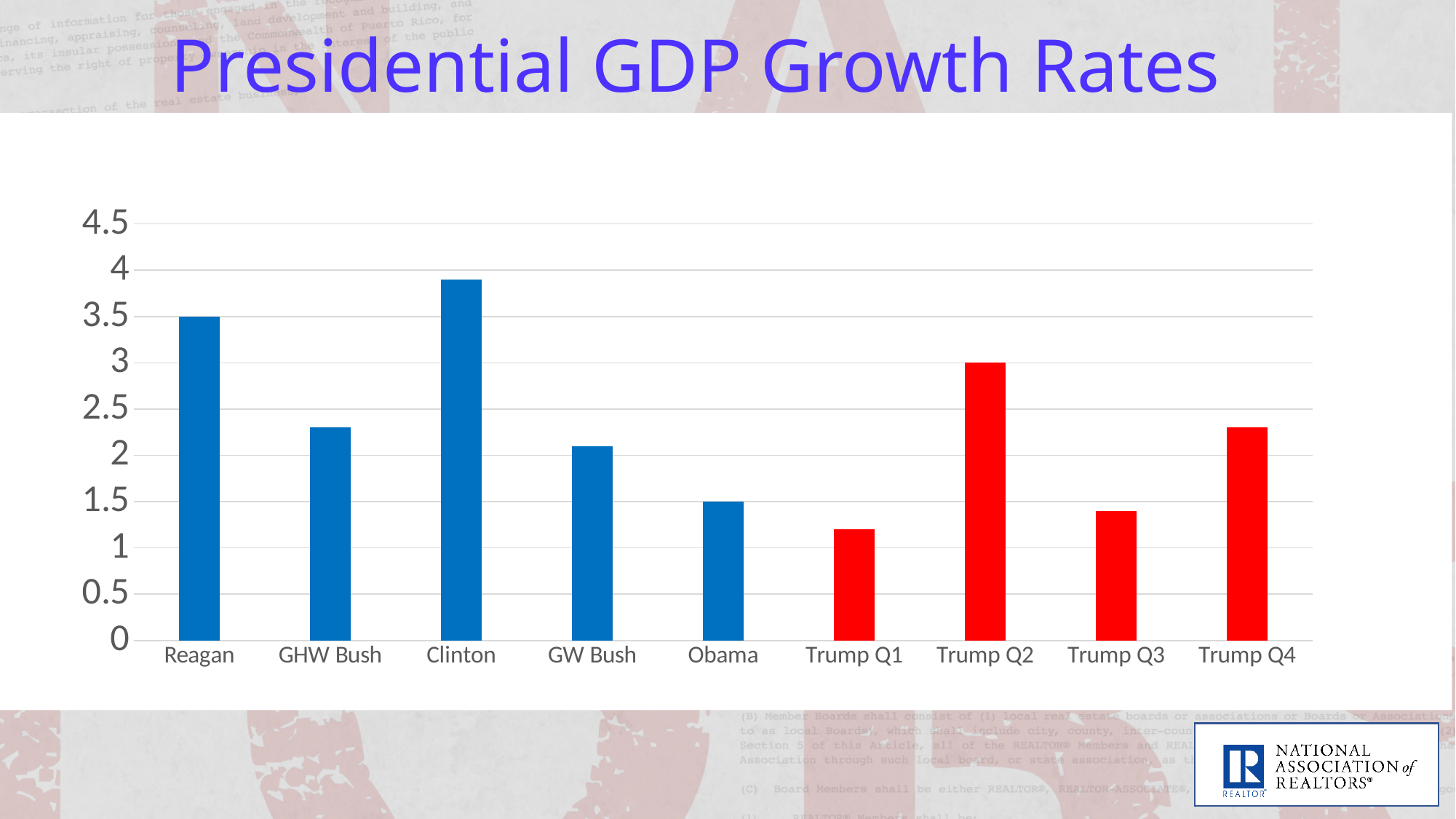
Which category has the highest GDP growth rate? Clinton What is the title of the chart? Presidential GDP Growth Rates What is the GDP growth rate for Obama? 1.5 Is the value for Trump Q3 greater or less than 1.5? less What is the GDP growth rate for Trump Q2? 3 What kind of chart is shown on the slide? bar chart Which is larger, the value for Clinton or the value for Reagan? Clinton Which category has the lowest GDP growth rate? Trump Q1 What colour are the bars for the Trump quarters? red What is the GDP growth rate for Reagan? 3.5 How many bars (categories) are shown in the chart? 9 Is the value for GW Bush greater or less than 2? greater